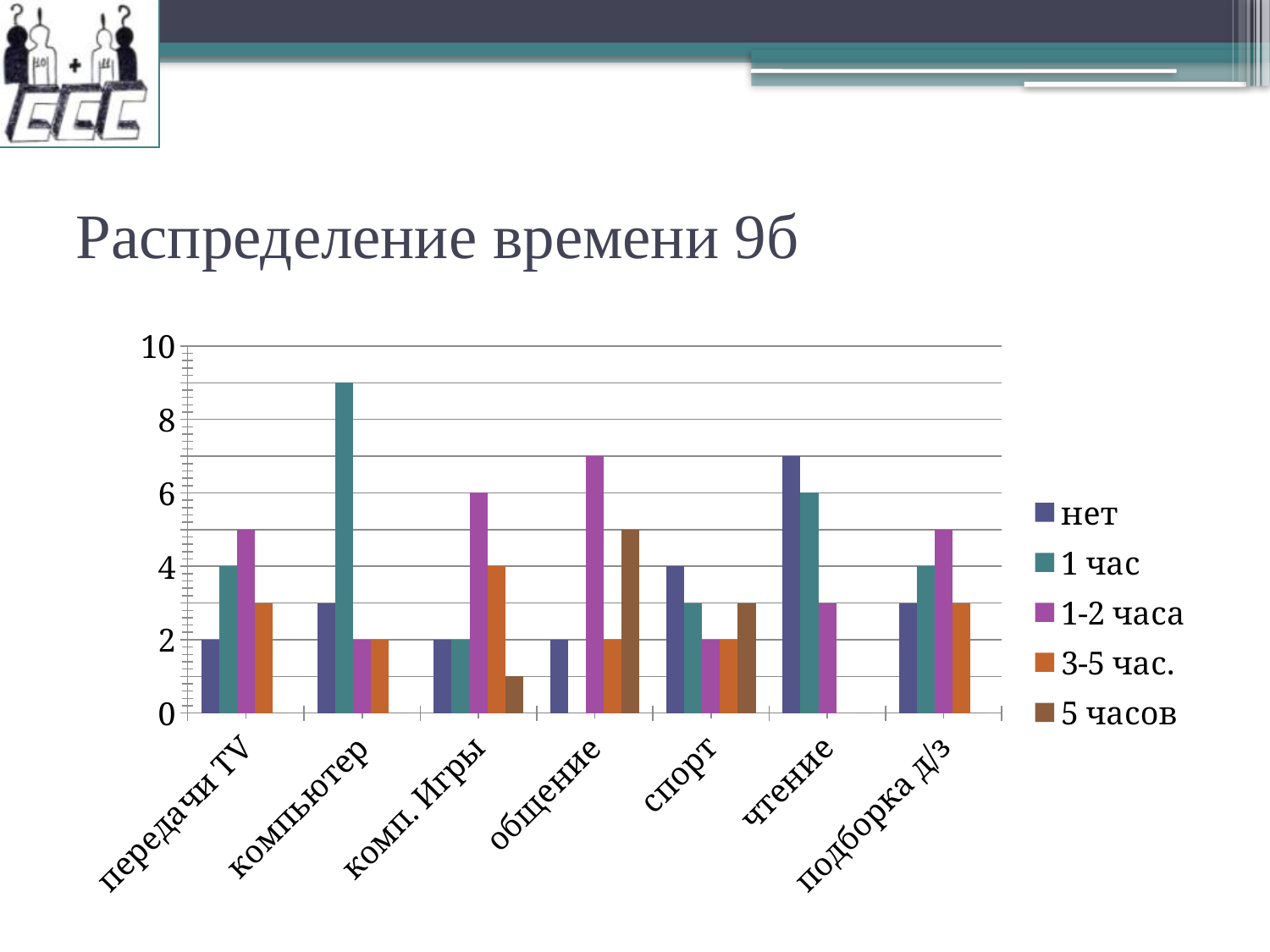
How many series does the legend list? 5 How many categories are shown along the x axis? 7 Is the value of the "1 час" series for "компьютер" greater or less than 8? greater What is the value of the "1-2 часа" series for "комп. Игры"? 6 What is the value of the "1 час" series for "передачи TV"? 4 Is the value of the "1-2 часа" series for "общение" greater or less than 6? greater What kind of chart is shown on the slide? bar chart What is the value of the "1 час" series for "чтение"? 6 What is the title of the slide containing the chart? Распределение времени 9б Which category has the highest value in the "1 час" series? компьютер For "чтение", which is larger: the "нет" value or the "1-2 часа" value? нет What is the difference between the "1 час" value for "чтение" and the "1 час" value for "передачи TV"? 2